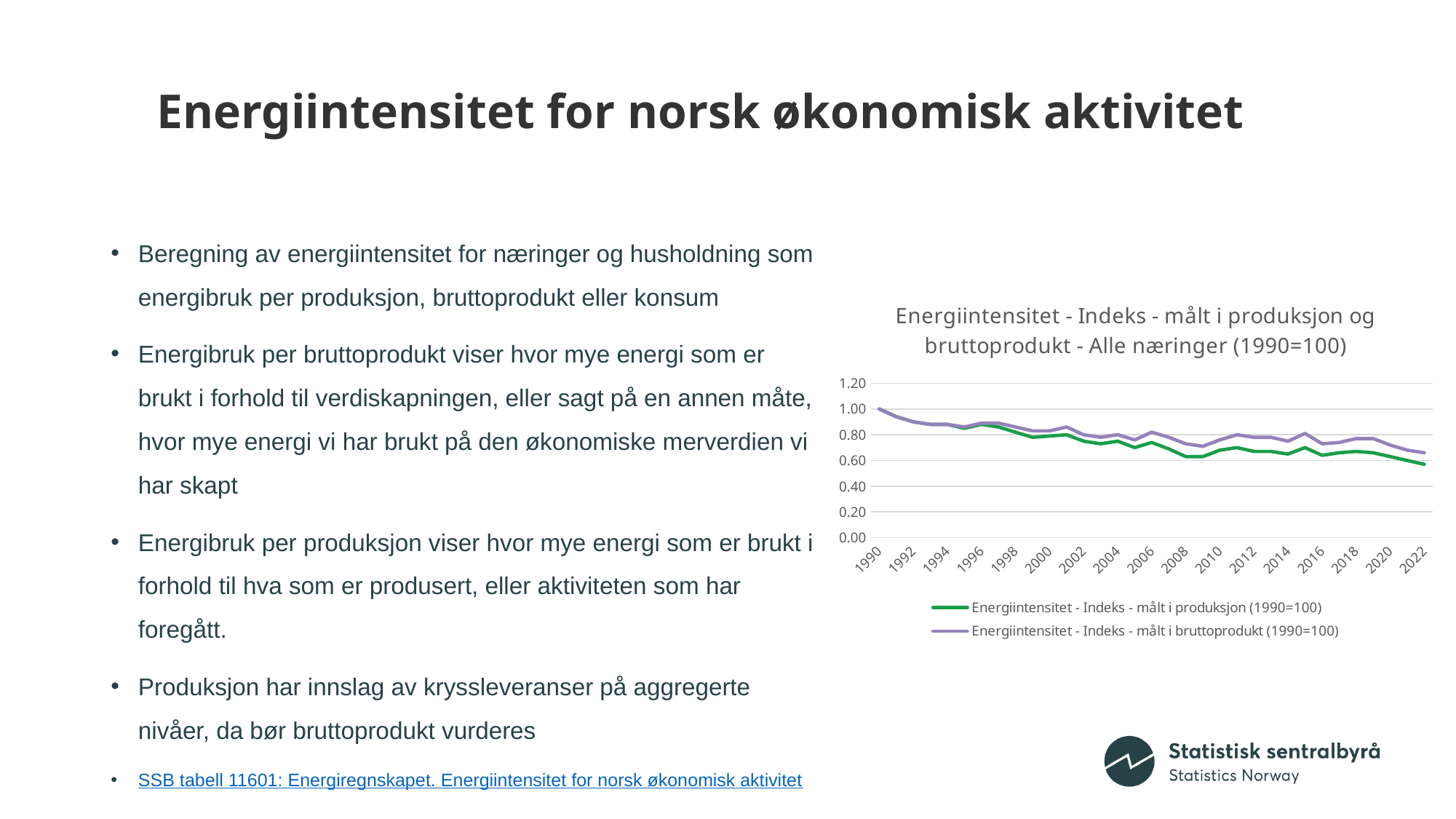
What is the value of the 'Energiintensitet - Indeks - målt i bruttoprodukt (1990=100)' series in 1990? 1.00 Do the values of the series generally rise or fall from 1990 to 2022? fall Is the value of the 'målt i bruttoprodukt' series in 2010 greater or less than 0.80? less In 2022, which series has the higher value: 'målt i produksjon' or 'målt i bruttoprodukt'? Energiintensitet - Indeks - målt i bruttoprodukt (1990=100) In which year is the 'målt i produksjon' series at its highest value? 1990 What kind of chart is shown on the slide? line chart What is the value of the 'Energiintensitet - Indeks - målt i produksjon (1990=100)' series in 1990? 1.00 Which colour is used for the 'Energiintensitet - Indeks - målt i produksjon (1990=100)' series? green What is the title of the chart? Energiintensitet - Indeks - målt i produksjon og bruttoprodukt - Alle næringer (1990=100) Is the value of the 'målt i produksjon' series in 2010 greater or less than 0.80? less How many series does the chart legend list? 2 Is the value of the 'målt i bruttoprodukt' series in 2022 greater or less than 0.60? greater